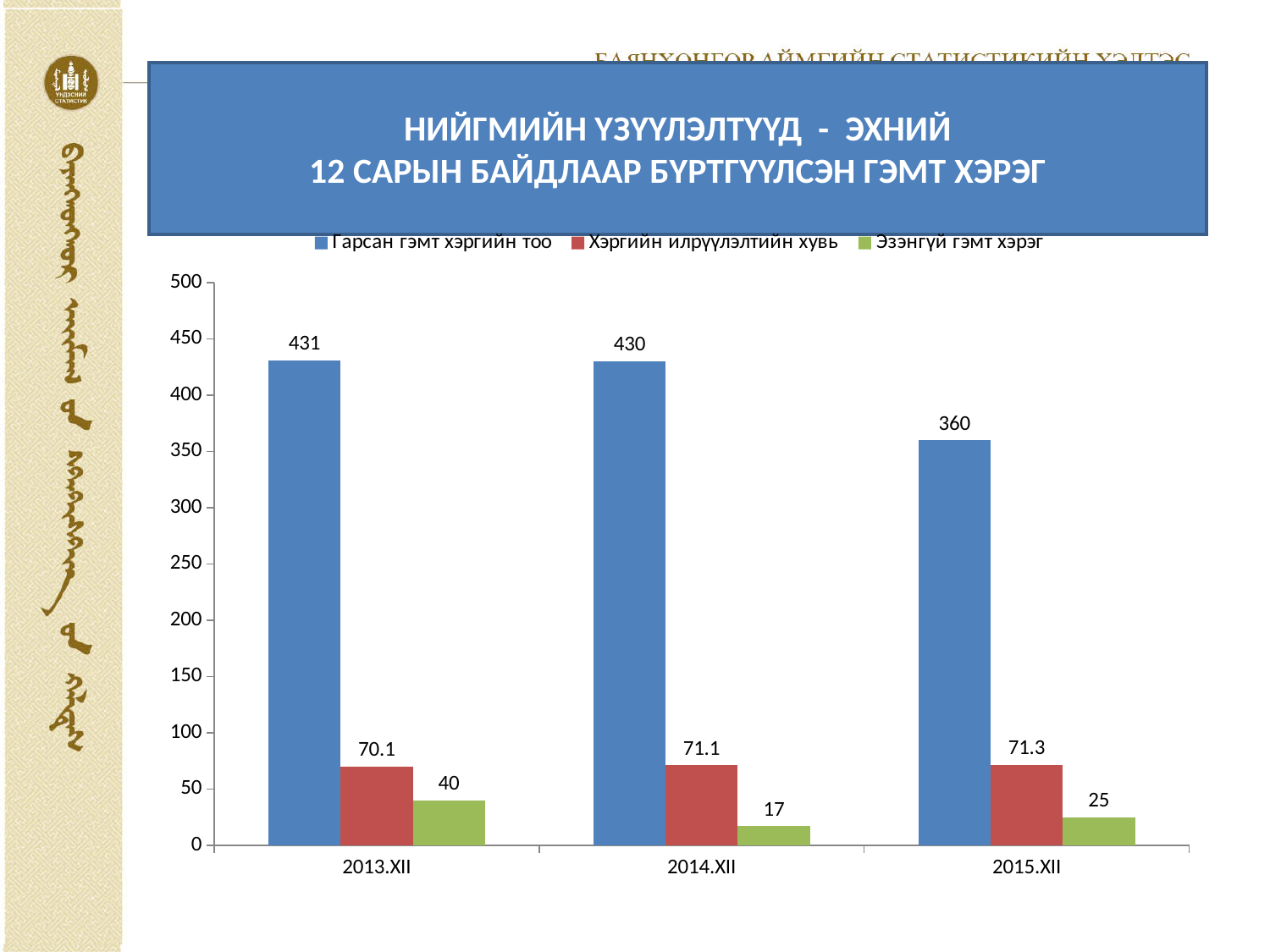
What kind of chart is shown on the slide? bar chart Is the value of Гарсан гэмт хэргийн тоо for 2015.XII greater or less than 400? less What is the difference between Гарсан гэмт хэргийн тоо in 2014.XII and 2015.XII? 70 How many series does the legend list? 3 Which is larger: Эзэнгүй гэмт хэрэг in 2013.XII or in 2015.XII? 2013.XII Does Хэргийн илрүүлэлтийн хувь rise or fall from 2013.XII to 2015.XII? rise How many periods are shown on the x axis? 3 In which period is Гарсан гэмт хэргийн тоо lowest? 2015.XII What is the value of Хэргийн илрүүлэлтийн хувь for 2015.XII? 71.3 In which period is Эзэнгүй гэмт хэрэг highest? 2013.XII What is the value of Гарсан гэмт хэргийн тоо for 2013.XII? 431 What is the value of Эзэнгүй гэмт хэрэг for 2014.XII? 17